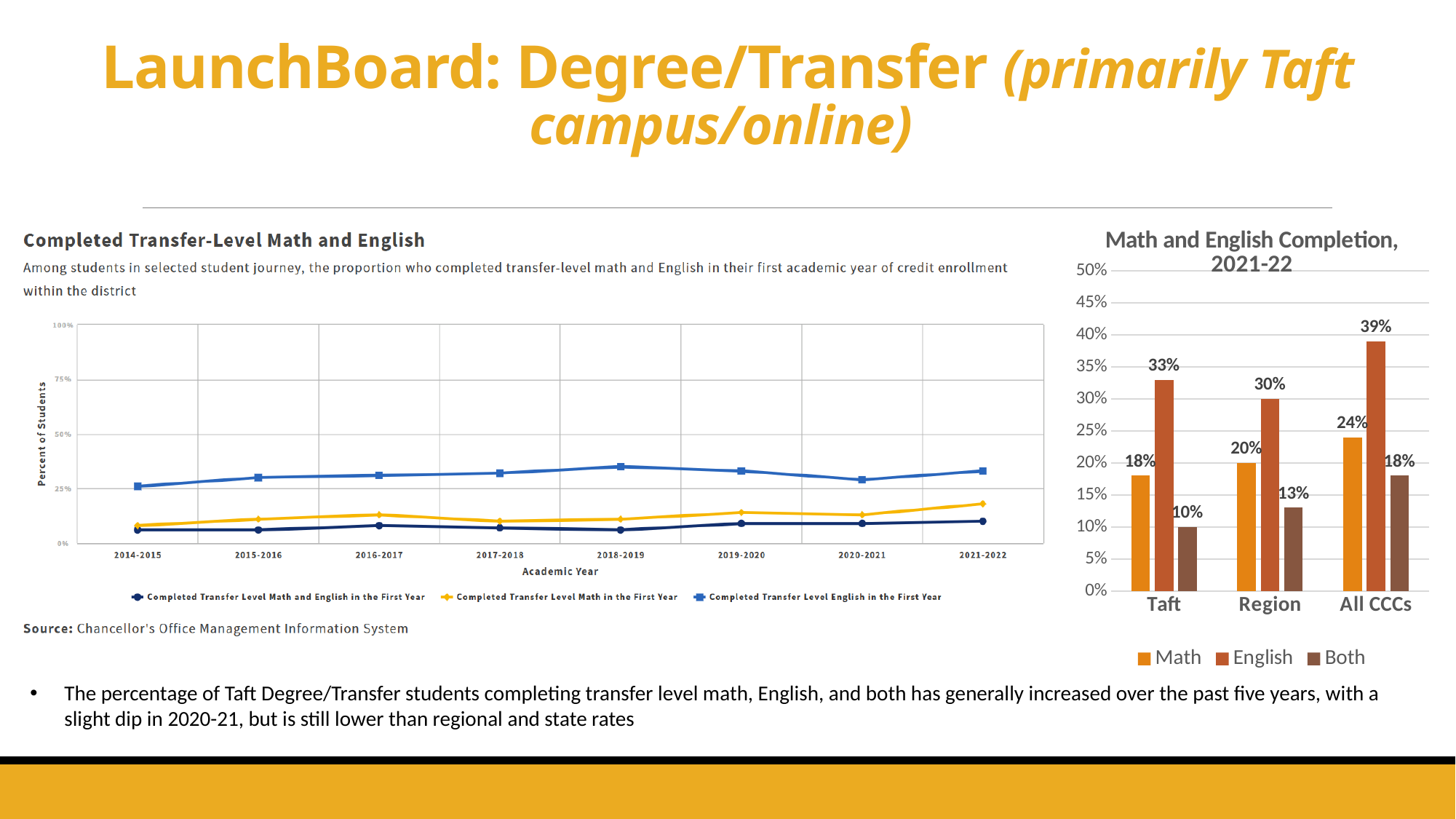
In the 'Math and English Completion, 2021-22' chart, what is the Both value for Region? 13% In the 'Math and English Completion, 2021-22' chart, which category has the highest English value? All CCCs What kind of chart is the 'Completed Transfer-Level Math and English' chart on the left? Line chart In the 'Math and English Completion, 2021-22' chart, how many categories are shown on the x axis? 3 In the 'Math and English Completion, 2021-22' chart, which category has the lowest Both value? Taft In the 'Math and English Completion, 2021-22' chart, which is larger: the Math value for Region or the Math value for Taft? Region In the 'Math and English Completion, 2021-22' chart, what is the Math value for All CCCs? 24% In the 'Math and English Completion, 2021-22' chart, what is the difference between the English values for All CCCs and Taft? 6% In the 'Completed Transfer-Level Math and English' chart, is the value for Completed Transfer Level English in the First Year in 2021-2022 greater or less than 25%? greater In the 'Math and English Completion, 2021-22' chart, how many series does the legend list? 3 In the 'Completed Transfer-Level Math and English' chart, how many academic years are shown on the x axis? 8 In the 'Math and English Completion, 2021-22' chart, what is the English completion value for Taft? 33%